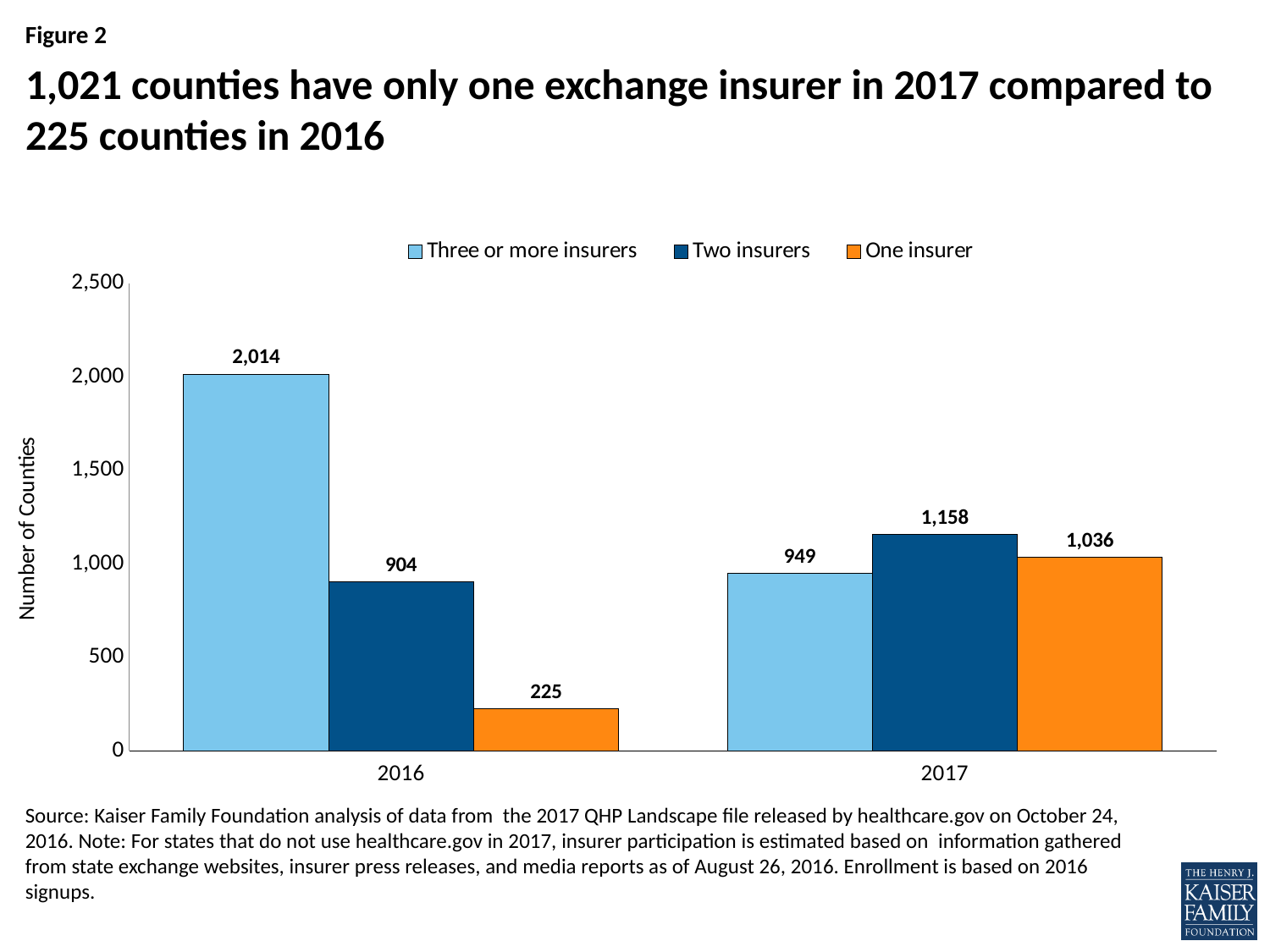
What kind of chart is shown on the slide? Bar chart Which series has the lowest value in 2016? One insurer Is the value for three or more insurers in 2017 greater or less than 1,000? less How many counties had three or more insurers in 2016? 2,014 How many counties had one insurer in 2017? 1,036 How many counties had two insurers in 2017? 1,158 Which is larger: the number of counties with two insurers in 2016 or in 2017? 2017 What is the difference between the number of counties with three or more insurers in 2016 and in 2017? 1,065 What is the difference between the number of counties with one insurer in 2017 and in 2016? 811 Which series has the highest value in 2017? Two insurers How many series does the legend list? 3 What is the y-axis label of the chart? Number of Counties